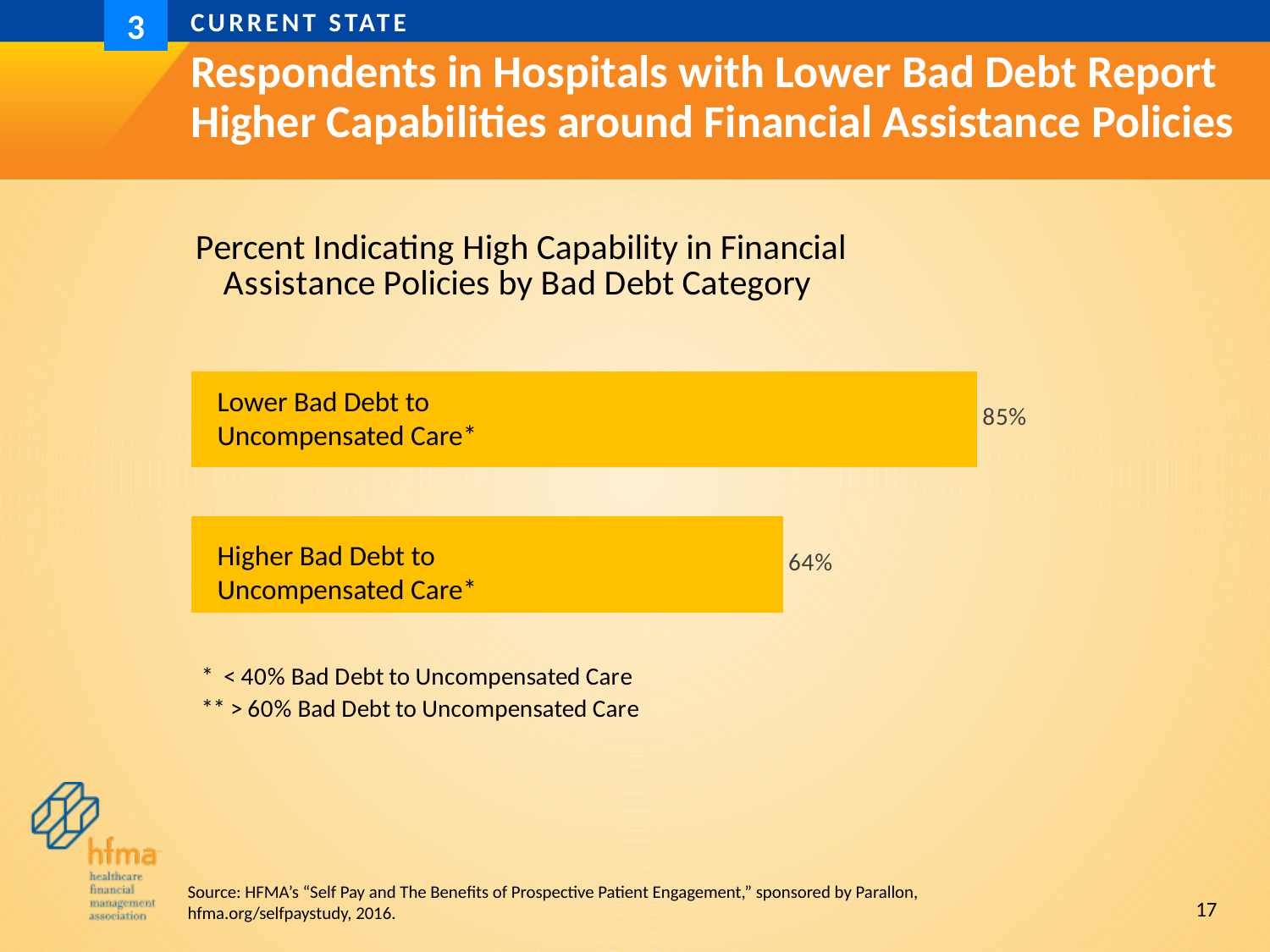
Which bad debt category has the highest percent indicating high capability in financial assistance policies? Lower Bad Debt to Uncompensated Care Which is larger: the value for Lower Bad Debt to Uncompensated Care or the value for Higher Bad Debt to Uncompensated Care? Lower Bad Debt to Uncompensated Care What kind of chart is shown on the slide? Bar chart What percent of respondents in hospitals with Lower Bad Debt to Uncompensated Care indicate high capability in financial assistance policies? 85% What percent of respondents in hospitals with Higher Bad Debt to Uncompensated Care indicate high capability in financial assistance policies? 64% Which bad debt category has the lowest percent indicating high capability in financial assistance policies? Higher Bad Debt to Uncompensated Care What is the difference in percentage points between the Lower Bad Debt and Higher Bad Debt categories? 21 percentage points What colour are the bars in the chart? Yellow What is the title of the chart? Percent Indicating High Capability in Financial Assistance Policies by Bad Debt Category How many bad debt categories are shown in the chart? 2